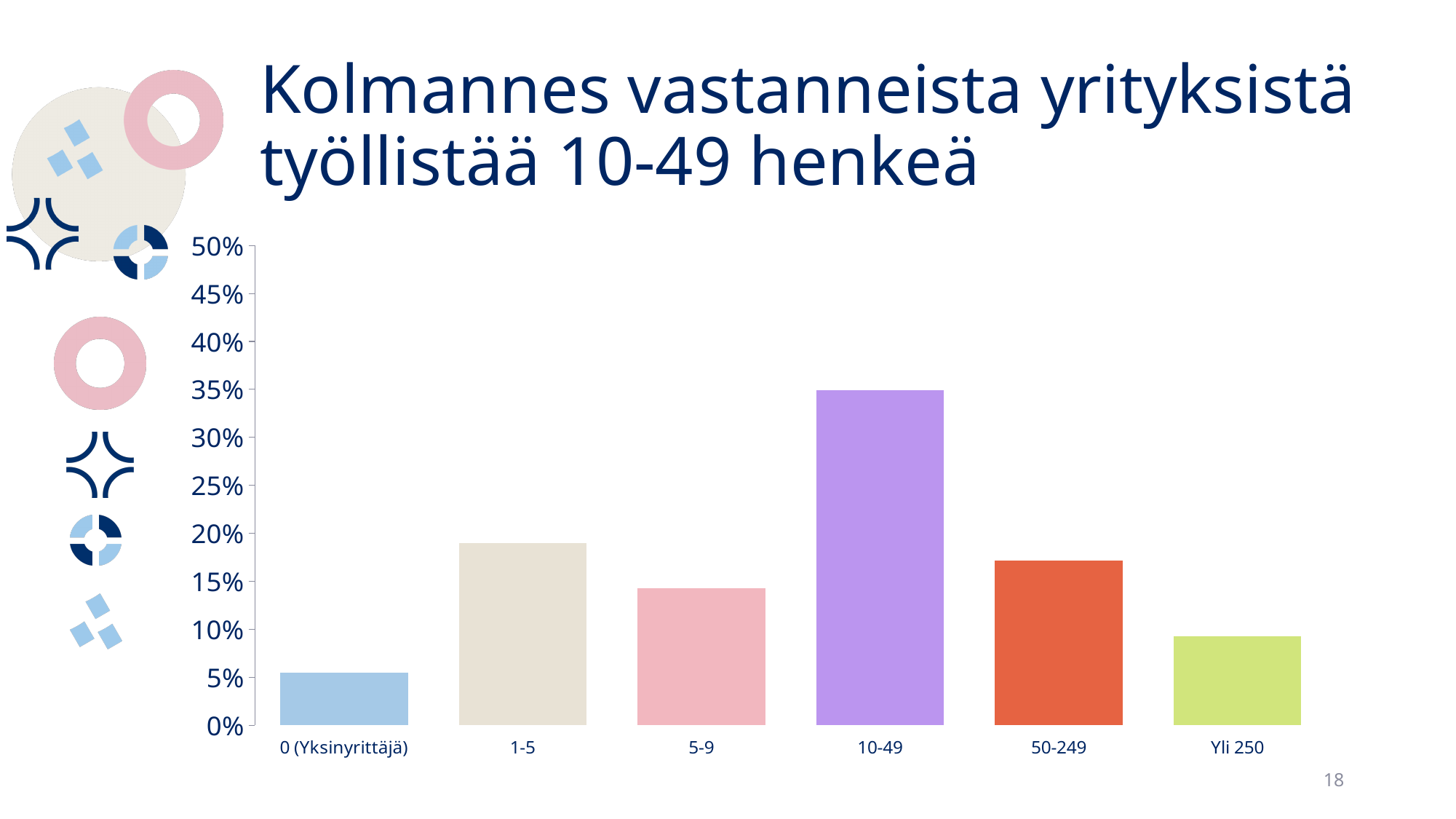
Which is larger, the value for 1-5 or the value for 5-9? 1-5 Is the value for 1-5 greater or less than 25%? less Is the value for 50-249 greater or less than 15%? greater How many company size categories are shown on the x axis? 6 Is the value for Yli 250 greater or less than 15%? less What kind of chart is shown on the slide? Bar chart Which category has the lowest value? 0 (Yksinyrittäjä) Which category has the highest value? 10-49 Which is larger, the value for 50-249 or the value for Yli 250? 50-249 What is the title of the slide? Kolmannes vastanneista yrityksistä työllistää 10-49 henkeä